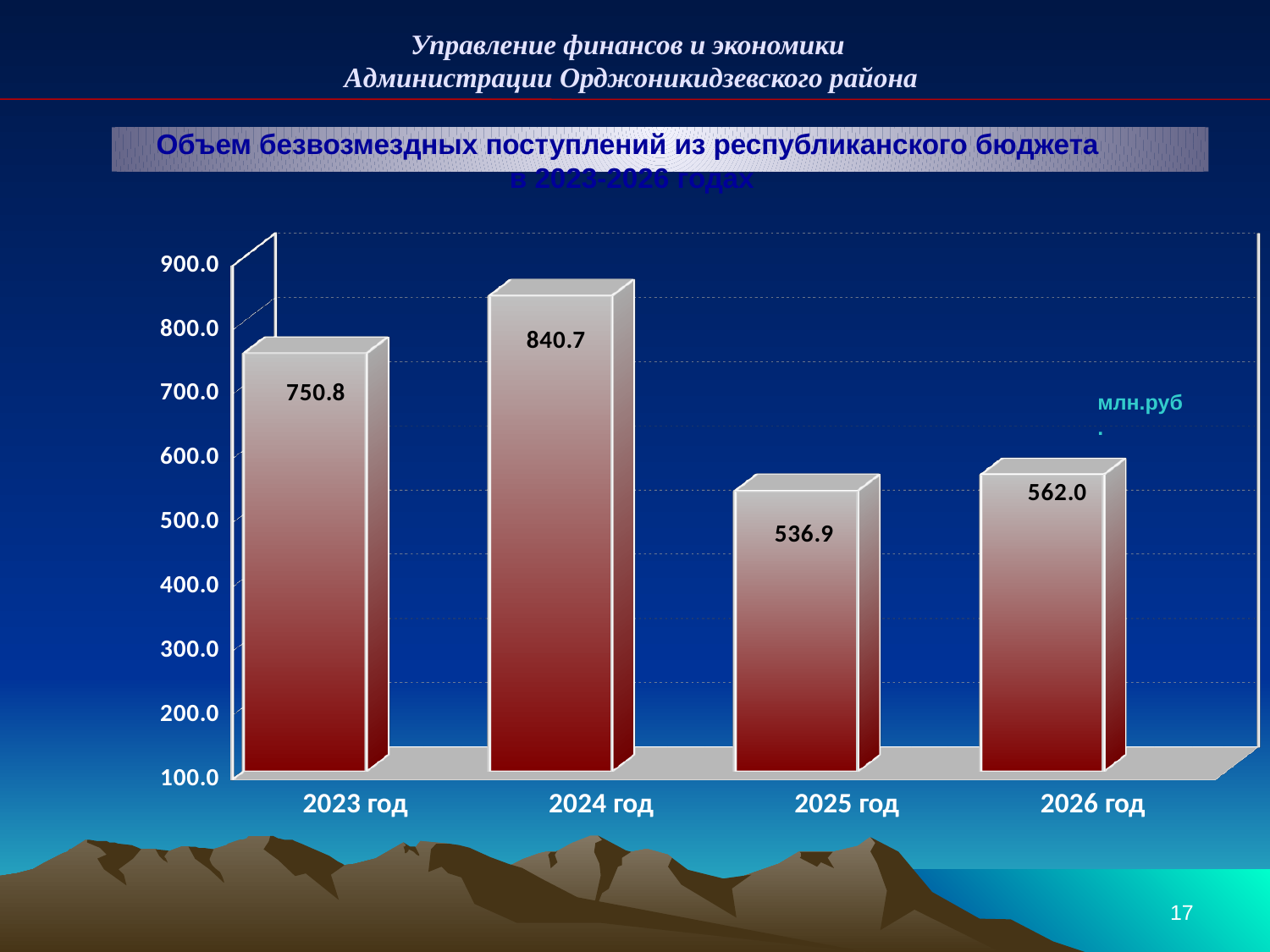
What is the value for 2026 год? 562.0 What is the value for 2025 год? 536.9 What is the difference between the values for 2026 год and 2025 год? 25.1 What is the value for 2024 год? 840.7 Which year has the lowest value? 2025 год Which year has the highest value? 2024 год What is the value for 2023 год? 750.8 What kind of chart is shown on the slide? bar chart What unit is indicated for the values on the chart? млн.руб. Which is larger, the value for 2023 год or the value for 2026 год? 2023 год What is the difference between the values for 2024 год and 2023 год? 89.9 How many years are shown on the chart? 4